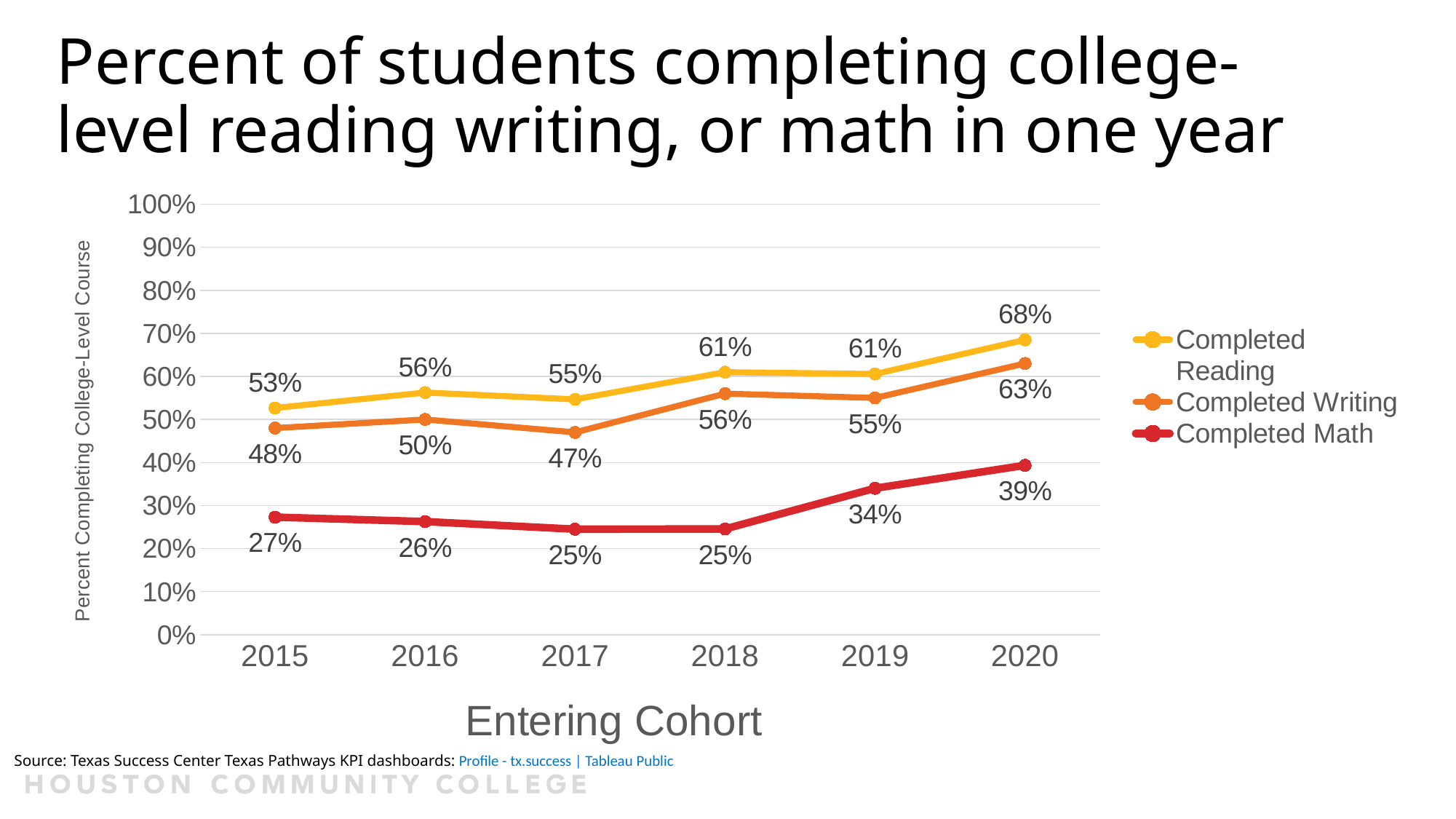
What is the Completed Math value for the 2017 entering cohort? 25% Which entering cohort has the lowest Completed Writing value? 2017 Does the Completed Math value rise or fall from the 2018 cohort to the 2020 cohort? Rise What percent of the 2020 entering cohort completed college-level reading in one year? 68% How many series does the legend list? 3 Which is larger for the 2019 cohort: Completed Reading or Completed Writing? Completed Reading What is the difference between the Completed Reading and Completed Math values for the 2015 cohort? 26% What is the Completed Writing value for the 2016 entering cohort? 50% How many entering cohorts are shown on the x axis? 6 What is the label of the x axis? Entering Cohort What kind of chart is shown on the slide? Line chart Which entering cohort has the highest Completed Math value? 2020